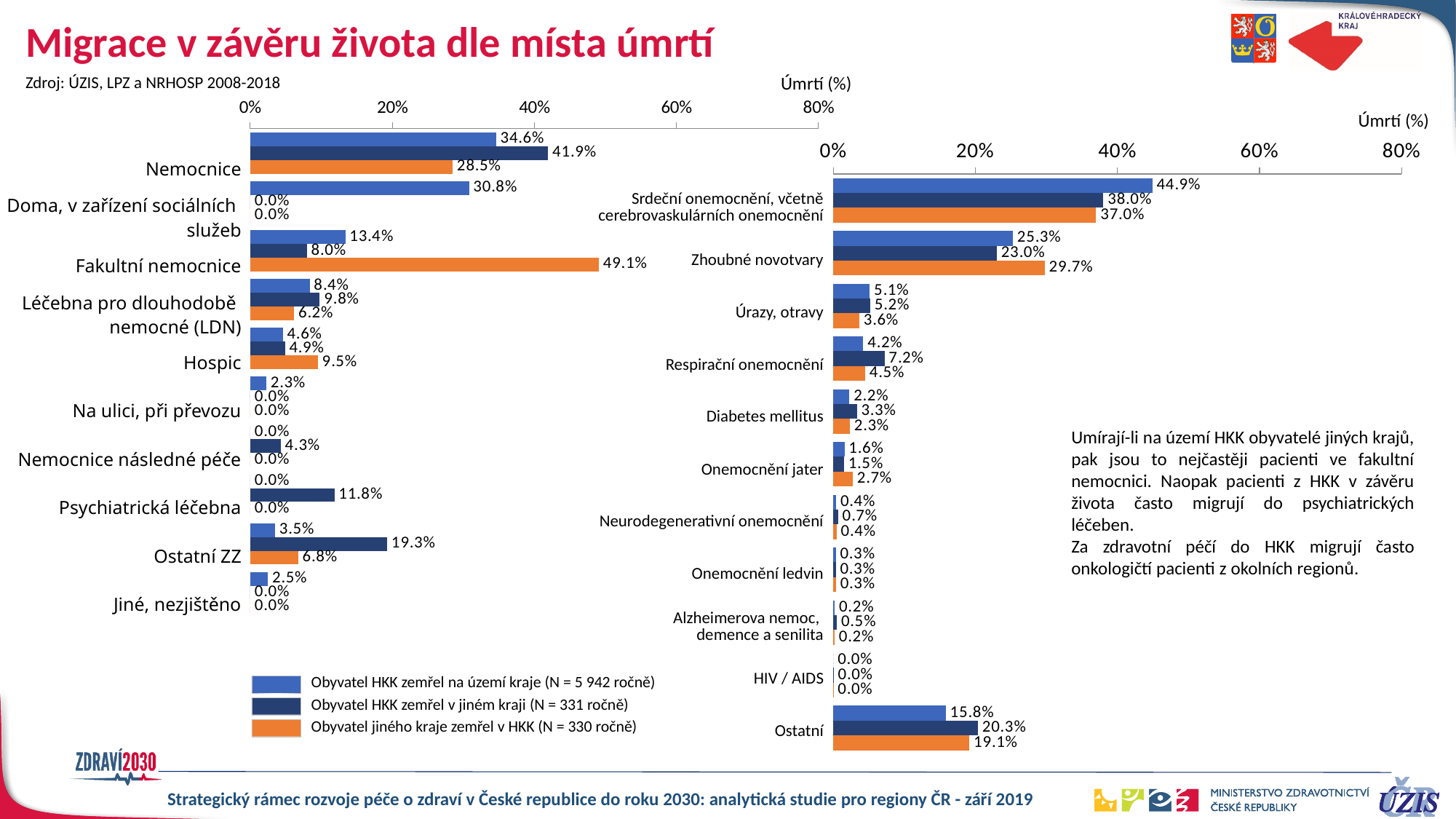
In the left chart, what is the value for Psychiatrická léčebna in the series 'Obyvatel HKK zemřel v jiném kraji'? 11.8% In the right chart, what is the value for Zhoubné novotvary in the series 'Obyvatel jiného kraje zemřel v HKK'? 29.7% In the left chart, what is the value for Fakultní nemocnice in the series 'Obyvatel jiného kraje zemřel v HKK'? 49.1% In the right chart, which is larger for Respirační onemocnění: the 'Obyvatel HKK zemřel v jiném kraji' value or the 'Obyvatel jiného kraje zemřel v HKK' value? Obyvatel HKK zemřel v jiném kraji How many categories does the right chart show? 11 In the right chart, which category has the highest value in the series 'Obyvatel HKK zemřel na území kraje'? Srdeční onemocnění, včetně cerebrovaskulárních onemocnění In the left chart, is the value for Nemocnice in the series 'Obyvatel HKK zemřel v jiném kraji' greater or less than 40%? greater What kind of chart is the left chart? Bar chart In the left chart, which category has the highest value in the series 'Obyvatel HKK zemřel na území kraje'? Nemocnice How many categories does the left chart show? 10 How many series does the legend list? 3 In the left chart, what is the difference between the 'Obyvatel HKK zemřel v jiném kraji' value and the 'Obyvatel HKK zemřel na území kraje' value for Ostatní ZZ? 15.8%